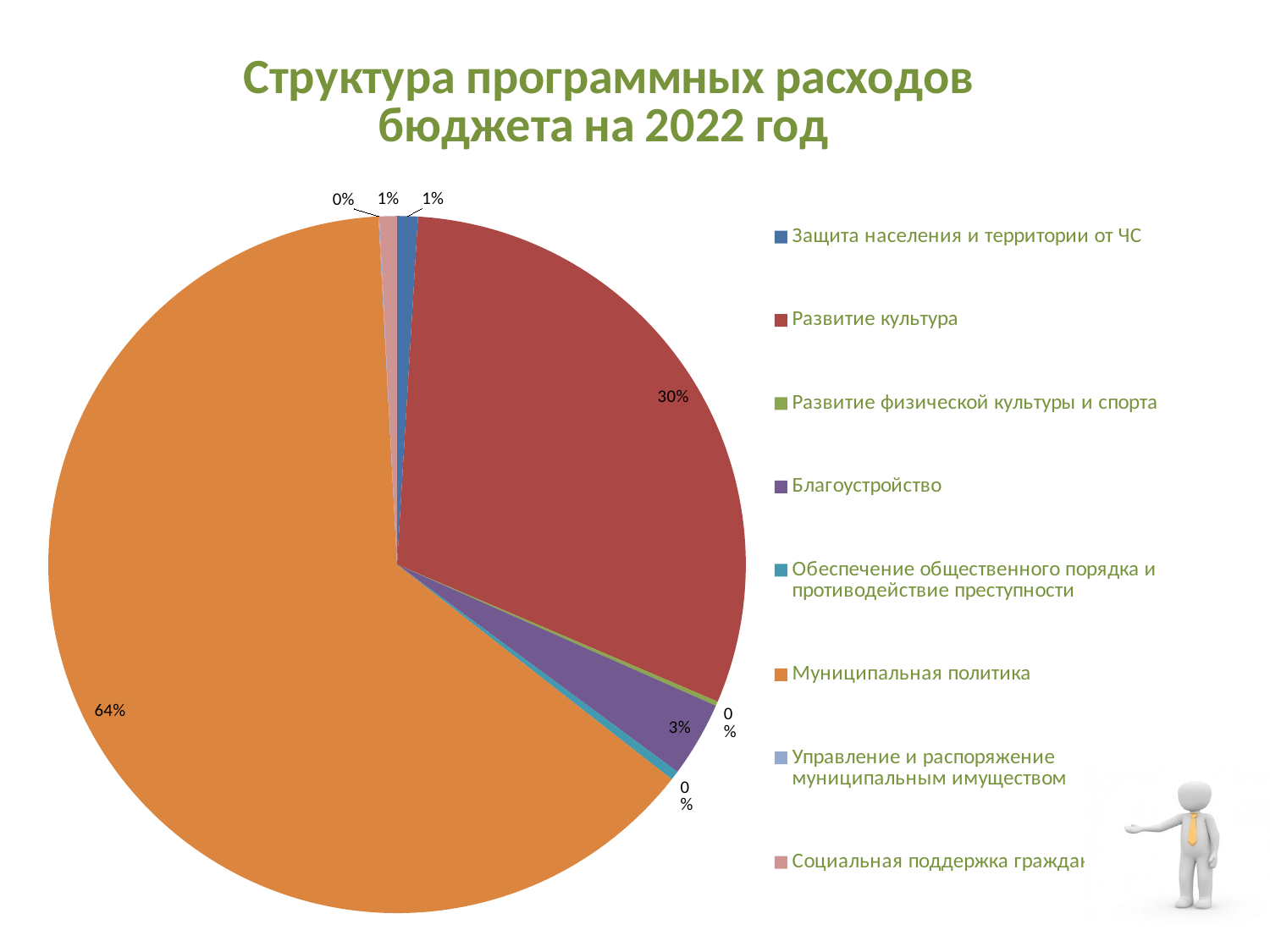
What is the value shown for Развитие физической культуры и спорта? 0% What colour is the slice for Муниципальная политика? orange What is the difference in percentage points between Муниципальная политика and Развитие культура? 34 What share of the pie does Муниципальная политика have? 64% What kind of chart is shown on the slide? pie chart What is the title of the chart? Структура программных расходов бюджета на 2022 год How many categories does the legend list? 8 Which category has the largest share of the pie? Муниципальная политика Which is larger, the share for Развитие культура or the share for Благоустройство? Развитие культура What is the value shown for Благоустройство? 3% What is the value shown for Защита населения и территории от ЧС? 1% What share of the pie does Развитие культура have? 30%